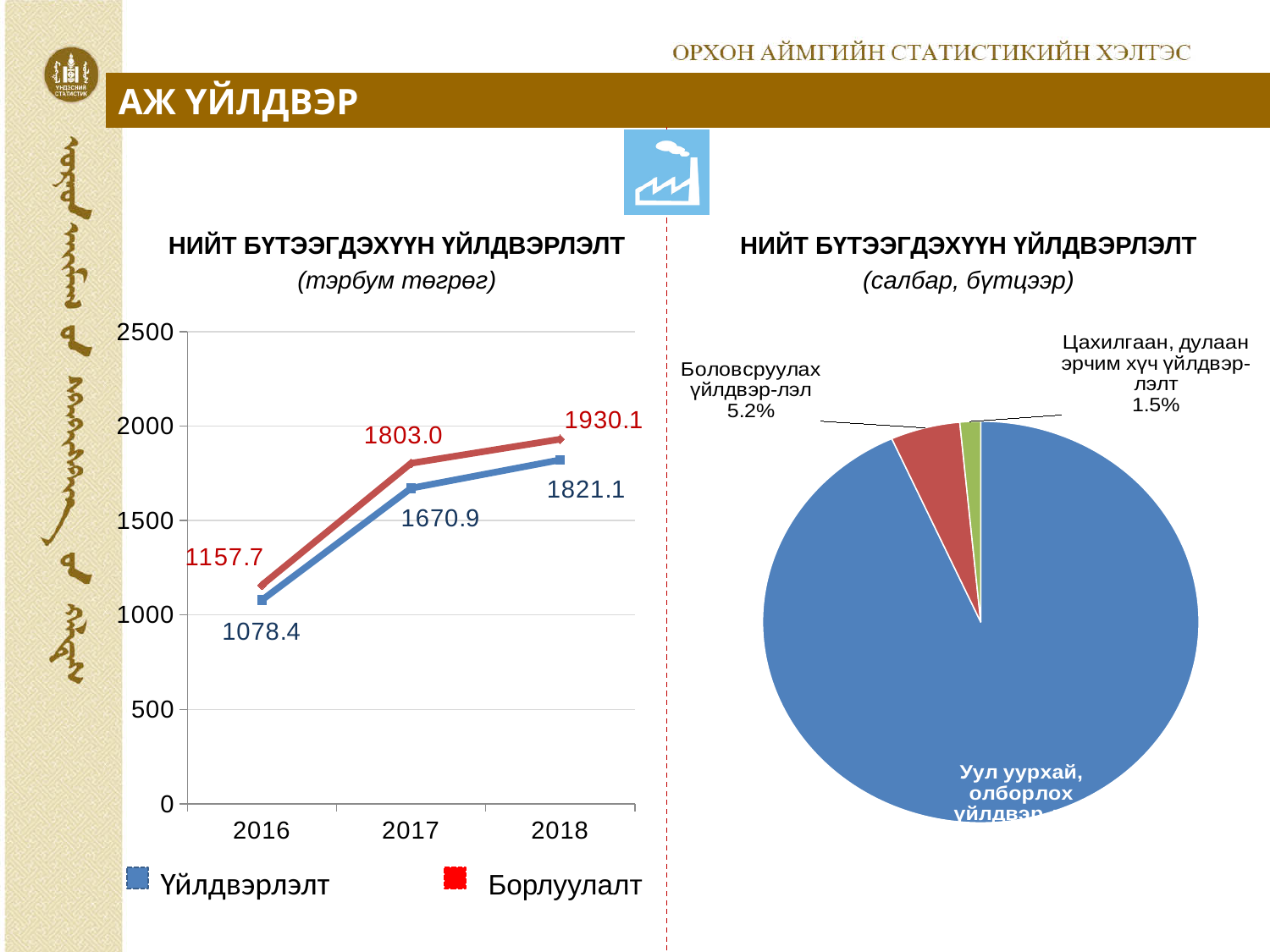
On the left chart (НИЙТ БҮТЭЭГДЭХҮҮН ҮЙЛДВЭРЛЭЛТ, тэрбум төгрөг), what is the value of Борлуулалт in 2017? 1803.0 On the left chart (НИЙТ БҮТЭЭГДЭХҮҮН ҮЙЛДВЭРЛЭЛТ, тэрбум төгрөг), how many series does the legend list? 2 On the right pie chart (НИЙТ БҮТЭЭГДЭХҮҮН ҮЙЛДВЭРЛЭЛТ, салбар, бүтцээр), what share does Боловсруулах үйлдвэрлэл have? 5.2% On the left chart (НИЙТ БҮТЭЭГДЭХҮҮН ҮЙЛДВЭРЛЭЛТ, тэрбум төгрөг), what is the difference between Борлуулалт and Үйлдвэрлэлт in 2018? 109.0 What kind of chart is the left chart (НИЙТ БҮТЭЭГДЭХҮҮН ҮЙЛДВЭРЛЭЛТ, тэрбум төгрөг)? line chart On the left chart (НИЙТ БҮТЭЭГДЭХҮҮН ҮЙЛДВЭРЛЭЛТ, тэрбум төгрөг), in which year is Үйлдвэрлэлт highest? 2018 On the right pie chart (НИЙТ БҮТЭЭГДЭХҮҮН ҮЙЛДВЭРЛЭЛТ, салбар, бүтцээр), which sector has the largest slice? Уул уурхай, олборлох үйлдвэр On the left chart (НИЙТ БҮТЭЭГДЭХҮҮН ҮЙЛДВЭРЛЭЛТ, тэрбум төгрөг), does Үйлдвэрлэлт rise or fall from 2016 to 2018? rise On the left chart (НИЙТ БҮТЭЭГДЭХҮҮН ҮЙЛДВЭРЛЭЛТ, тэрбум төгрөг), what is the value of Үйлдвэрлэлт in 2016? 1078.4 On the left chart (НИЙТ БҮТЭЭГДЭХҮҮН ҮЙЛДВЭРЛЭЛТ, тэрбум төгрөг), what is the value of Борлуулалт in 2018? 1930.1 On the left chart (НИЙТ БҮТЭЭГДЭХҮҮН ҮЙЛДВЭРЛЭЛТ, тэрбум төгрөг), in which year is Борлуулалт lowest? 2016 On the left chart (НИЙТ БҮТЭЭГДЭХҮҮН ҮЙЛДВЭРЛЭЛТ, тэрбум төгрөг), which is larger in 2017: Үйлдвэрлэлт or Борлуулалт? Борлуулалт